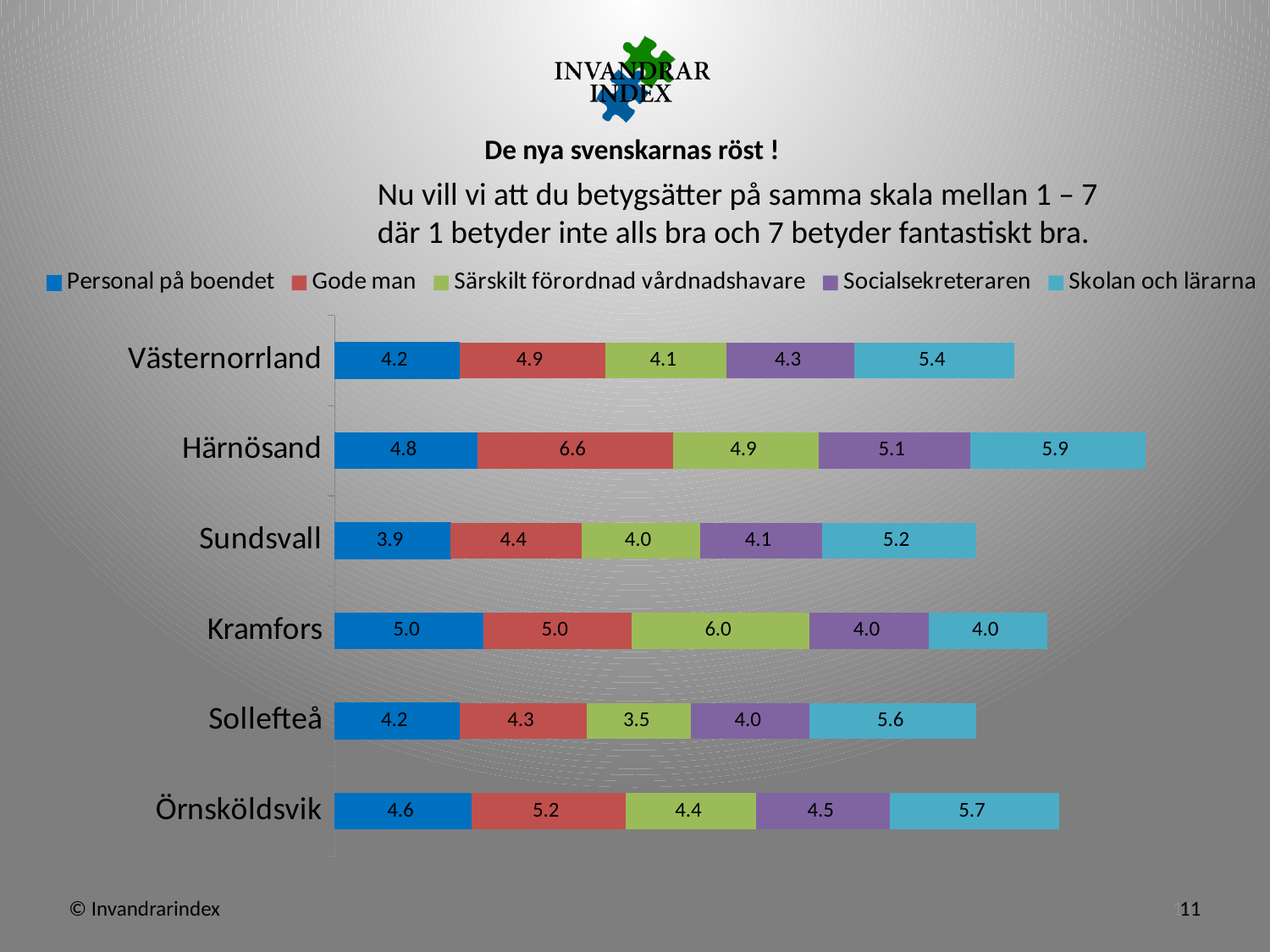
What is the value for Personal på boendet in Sundsvall? 3.9 What is the difference between the Skolan och lärarna values for Härnösand and Kramfors? 1.9 Which category has the highest value for Gode man? Härnösand How many series does the legend list? 5 Which is larger: the Socialsekreteraren value for Örnsköldsvik or for Sundsvall? Örnsköldsvik What is the total of the stacked bar for Härnösand? 27.3 Which category has the lowest value for Särskilt förordnad vårdnadshavare? Sollefteå What kind of chart is shown on the slide? Stacked bar chart What is the value for Särskilt förordnad vårdnadshavare in Kramfors? 6.0 What is the value for Skolan och lärarna in Sollefteå? 5.6 How many categories are shown on the chart? 6 What is the value for Gode man in Härnösand? 6.6